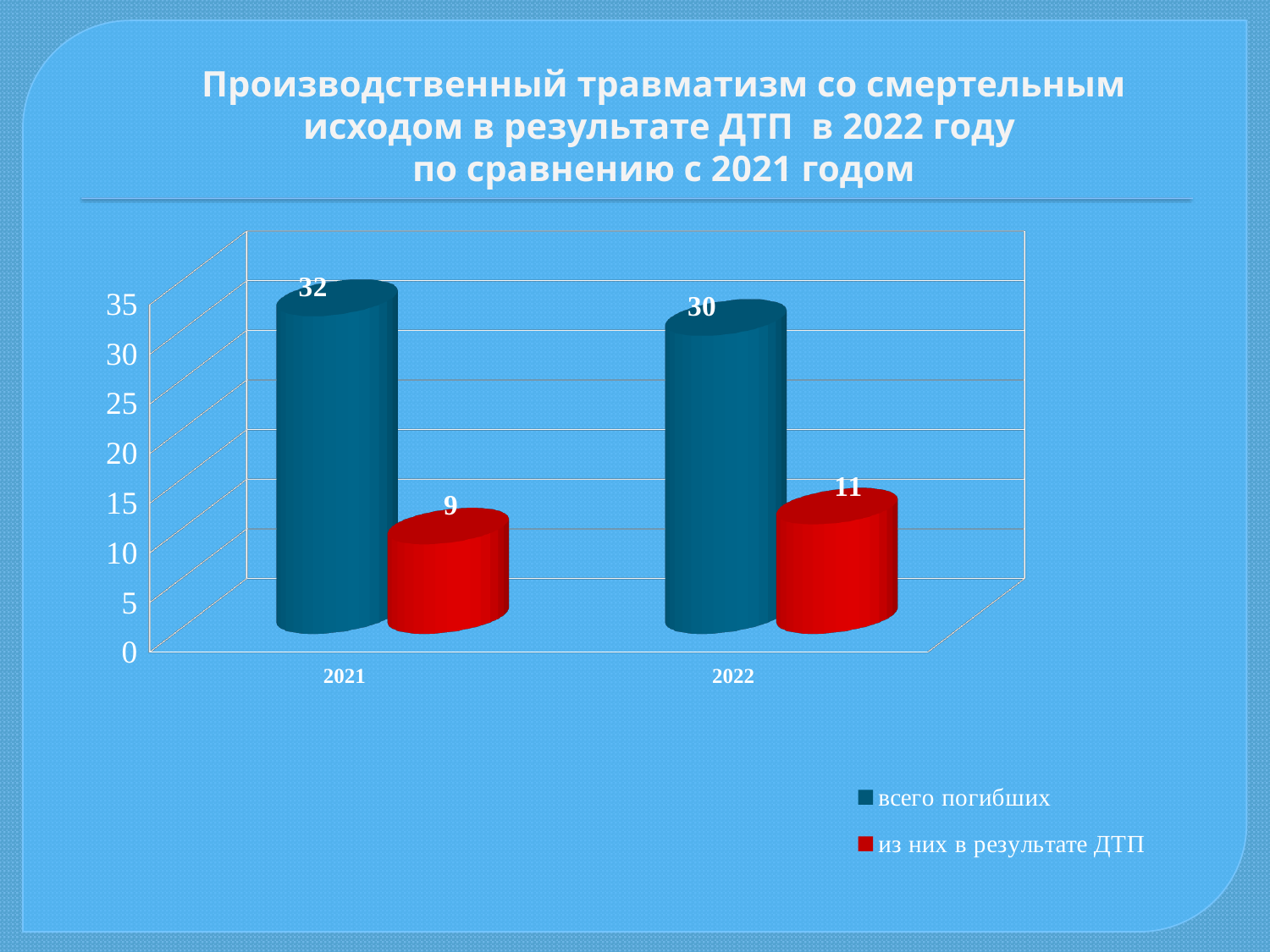
What is the value for "из них в результате ДТП" in 2021? 9 What is the value for "всего погибших" in 2021? 32 Is the value for "из них в результате ДТП" in 2022 larger or smaller than in 2021? larger What is the value for "всего погибших" in 2022? 30 What is the difference between "всего погибших" and "из них в результате ДТП" in 2022? 19 How many series does the legend list? 2 How many years are shown on the x axis? 2 What kind of chart is shown on the slide? bar chart Which year has the higher value for "всего погибших"? 2021 Which year has the lower value for "из них в результате ДТП"? 2021 By how much did "всего погибших" change from 2021 to 2022? 2 What is the value for "из них в результате ДТП" in 2022? 11